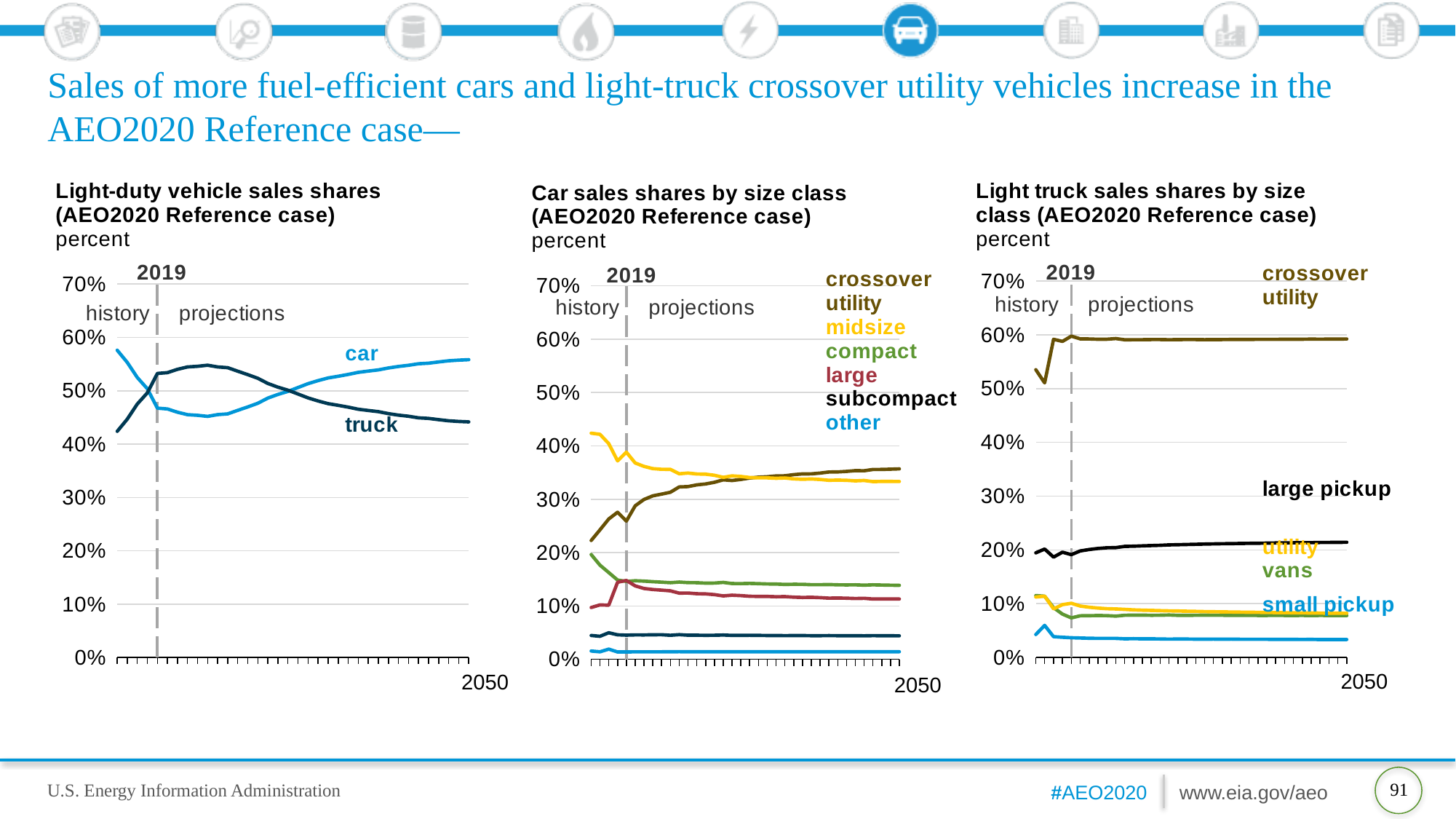
In the 'Light-duty vehicle sales shares' chart, is the value for truck in 2050 greater or less than 50%? less In the 'Car sales shares by size class' chart, is the value for compact in 2050 greater or less than 10%? greater What year does the dashed vertical line mark in each of the three charts? 2019 In the 'Car sales shares by size class' chart, does the midsize share rise or fall over the projection period? fall What kind of chart is the 'Light-duty vehicle sales shares' chart? line chart In the 'Light-duty vehicle sales shares' chart, how many series are plotted? 2 In the 'Car sales shares by size class' chart, does the crossover utility share rise or fall from the start of the chart to 2050? rise In the 'Light truck sales shares by size class' chart, which size class has the highest share in 2050? crossover utility In the 'Light-duty vehicle sales shares' chart, which series is higher in 2050, car or truck? car In the 'Car sales shares by size class' chart, how many size classes are listed in the legend? 6 In the 'Light truck sales shares by size class' chart, is the value for crossover utility in 2050 greater or less than 50%? greater In the 'Light truck sales shares by size class' chart, which size class has the lowest share in 2050? small pickup